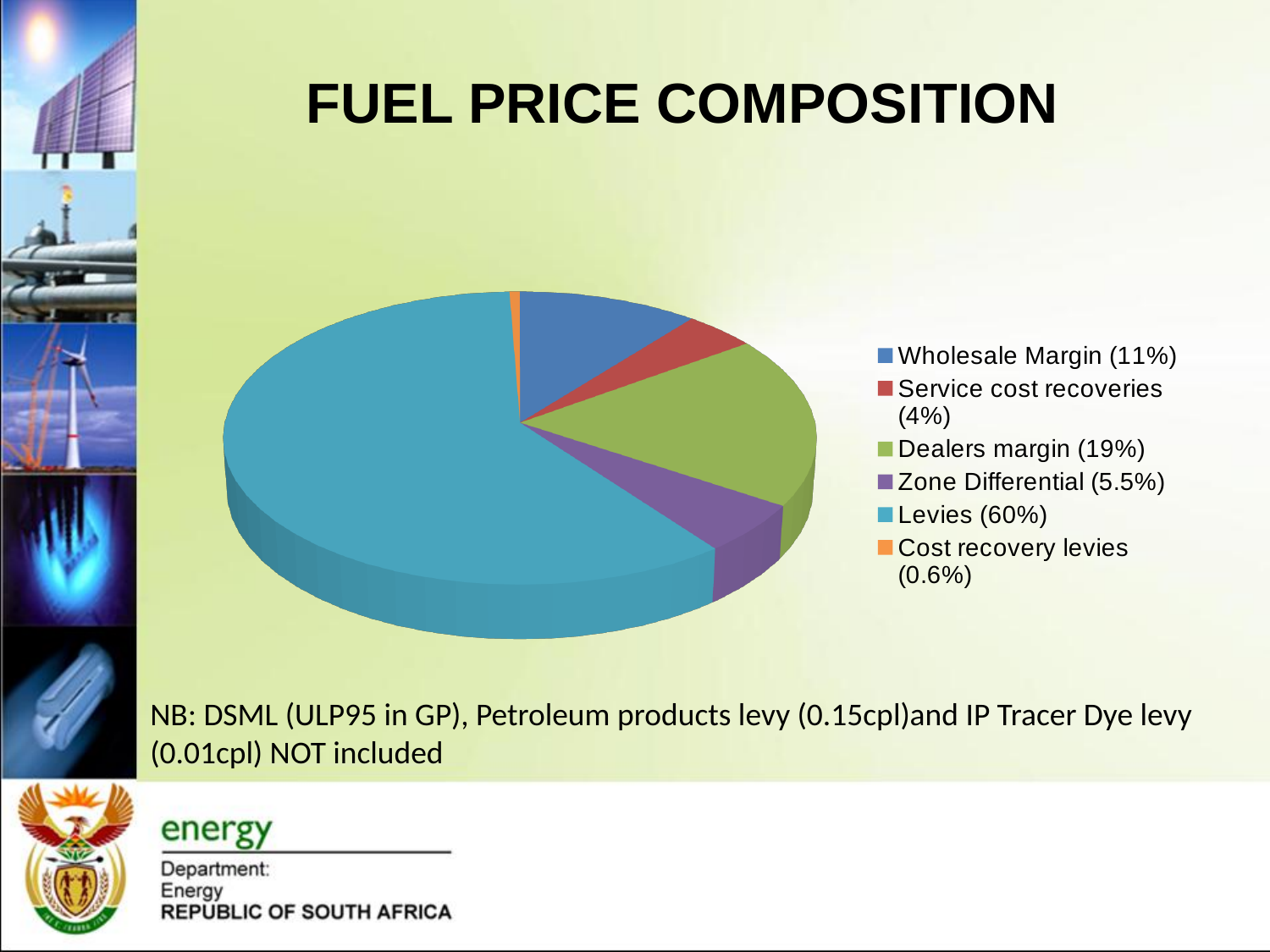
Which is larger, Service cost recoveries or Zone Differential? Zone Differential What is the difference in percentage points between Dealers margin and Wholesale Margin? 8 Which component has the smallest share of the fuel price? Cost recovery levies How many slices does the pie chart have? 6 What is the title of the chart? FUEL PRICE COMPOSITION What kind of chart is shown on the slide? pie chart What share of the fuel price is Dealers margin? 19% What share of the fuel price is Cost recovery levies? 0.6% What share of the fuel price is Zone Differential? 5.5% Which component has the largest share of the fuel price? Levies